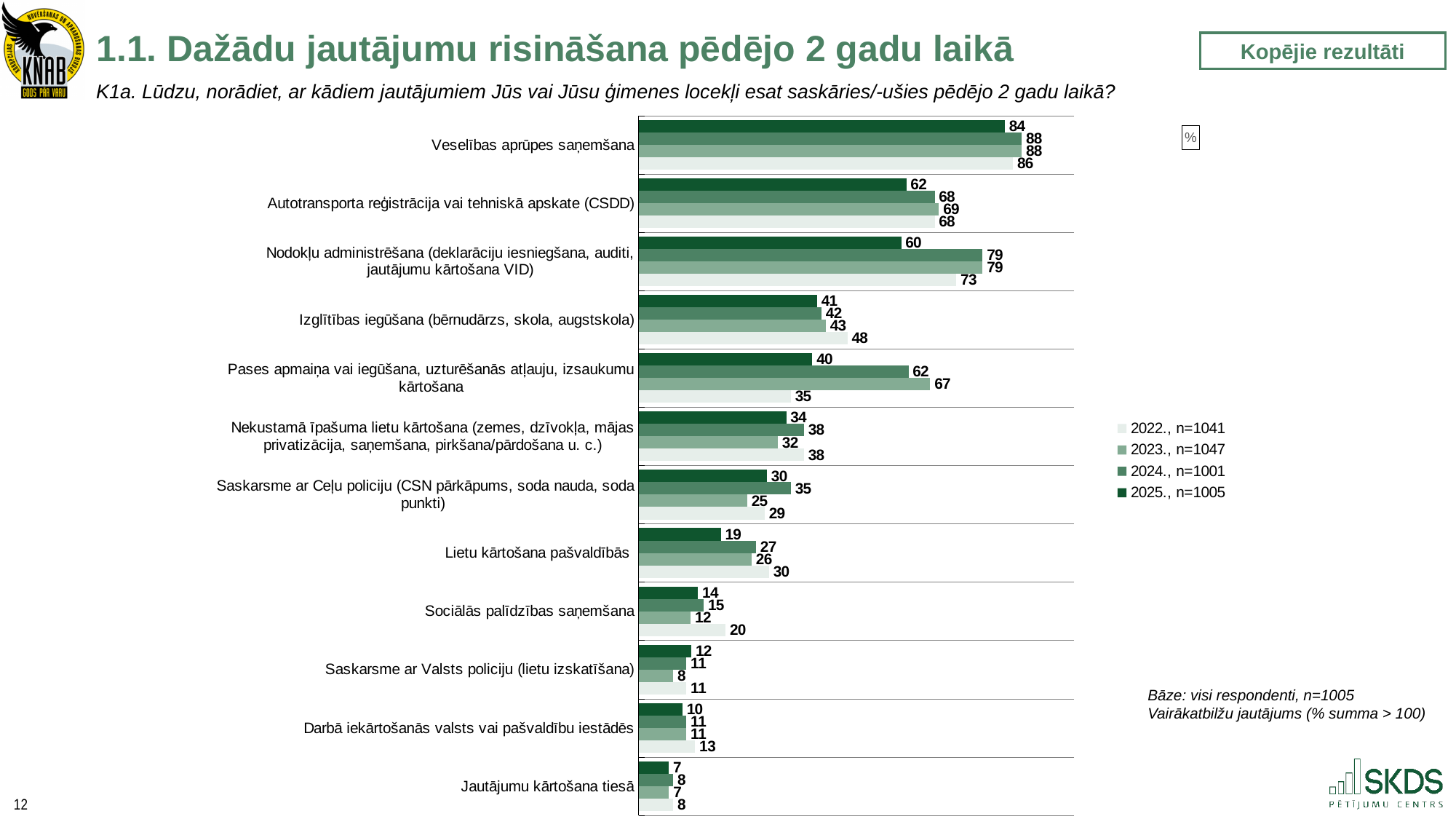
What kind of chart is shown on the slide? bar chart How many categories are plotted on the chart? 12 What is the value for 'Pases apmaiņa vai iegūšana, uzturēšanās atļauju, izsaukumu kārtošana' in the 2023 series? 67 Which category has the lowest value in the 2022 series? Jautājumu kārtošana tiesā Which category has the highest value in the 2025 series? Veselības aprūpes saņemšana For 'Sociālās palīdzības saņemšana', which series has the larger value, 2022 or 2025? 2022 How many series does the legend list? 4 What is the sample size (n) shown in the legend for the 2025 series? n=1005 What is the value for 'Nodokļu administrēšana (deklarāciju iesniegšana, auditi, jautājumu kārtošana VID)' in the 2022 series? 73 What is the difference between the 2022 and 2025 values for 'Lietu kārtošana pašvaldībās'? 11 What is the difference between the 2024 and 2025 values for 'Nodokļu administrēšana (deklarāciju iesniegšana, auditi, jautājumu kārtošana VID)'? 19 What is the value for 'Veselības aprūpes saņemšana' in the 2025 series? 84